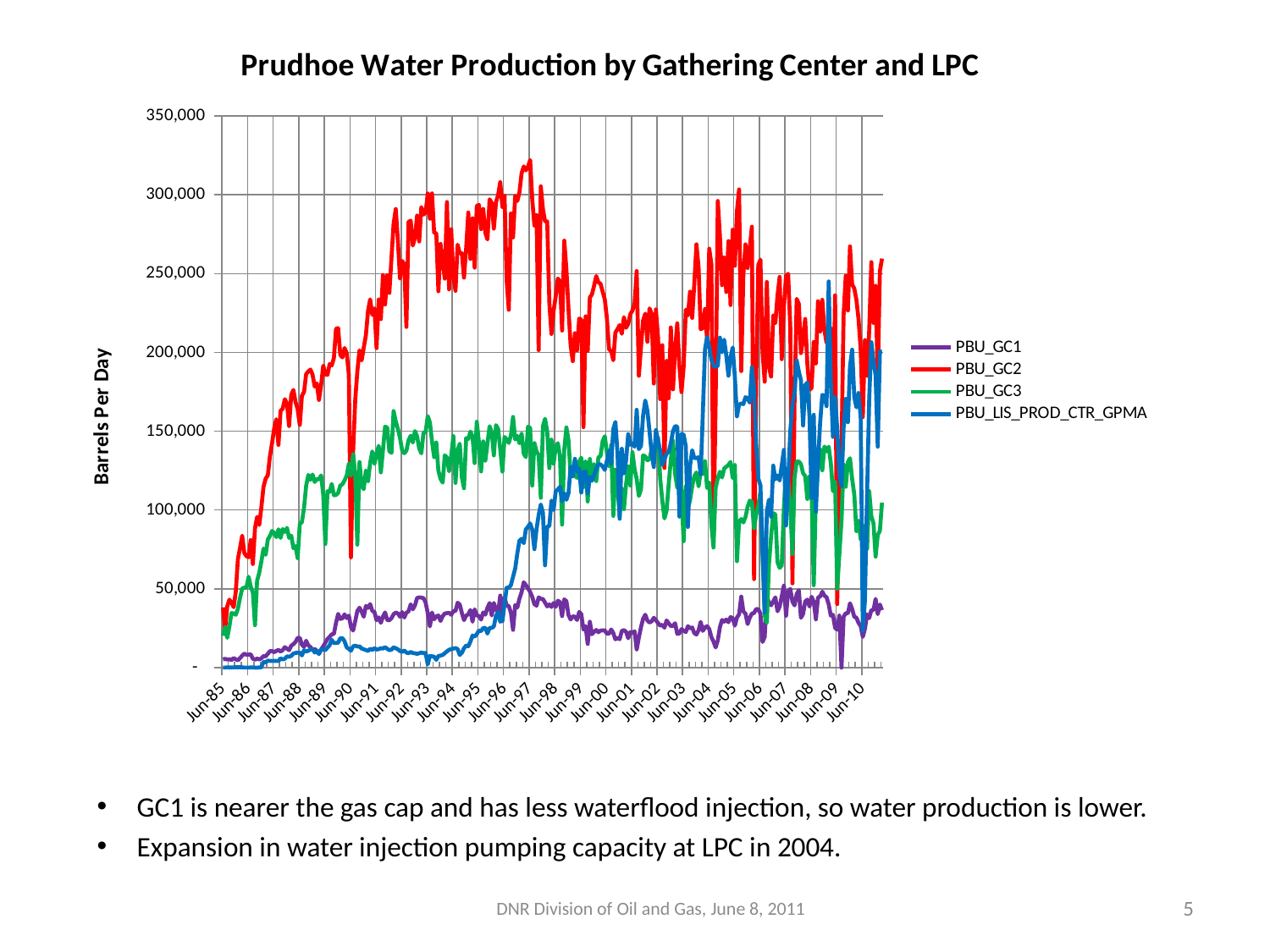
Is the value for PBU_LIS_PROD_CTR_GPMA at Jun-90 greater or less than 50,000? less What is the title of the chart? Prudhoe Water Production by Gathering Center and LPC Which series stays lowest across most of the chart? PBU_GC1 At Jun-92, which series has the larger value, PBU_GC2 or PBU_GC3? PBU_GC2 Is the value for PBU_GC1 at Jun-05 greater or less than 100,000? less Is the value for PBU_GC3 at Jun-92 greater or less than 100,000? greater Does the PBU_LIS_PROD_CTR_GPMA series generally rise or fall between Jun-85 and Jun-04? rise Which series reaches the highest value on the chart? PBU_GC2 What kind of chart is shown on the slide? line chart How many series does the legend list? 4 What is the label on the vertical axis? Barrels Per Day